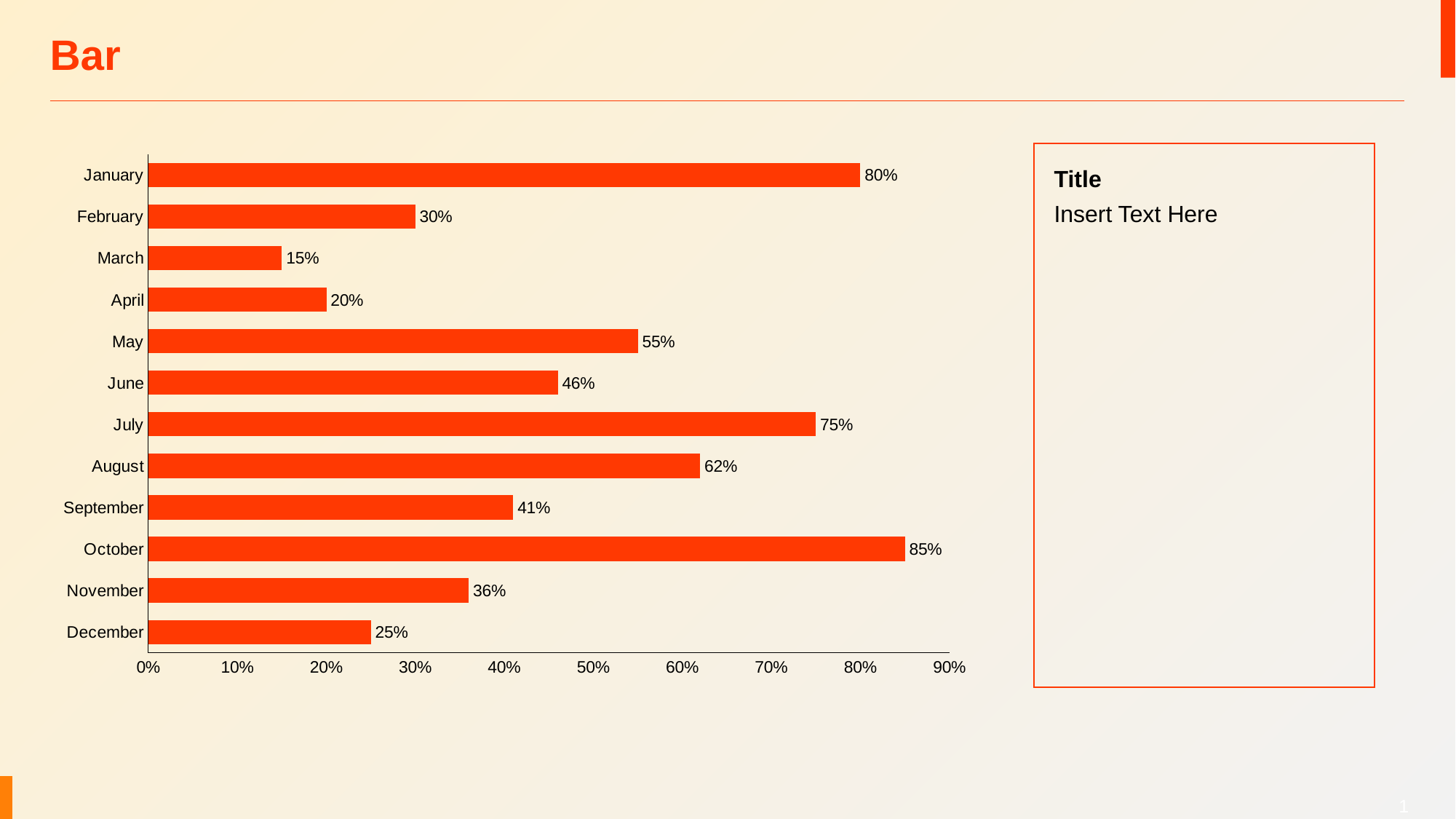
Is the value for June greater or less than 40%? greater What is the value for January? 80% Which month has the lowest value? March What colour are the bars in the chart? Orange-red What is the difference between the values for May and April? 35% What kind of chart is shown on the slide? Bar chart What is the value for September? 41% Which is larger, the value for July or the value for August? July What is the difference between the values for October and January? 5% What is the value for December? 25% How many months are shown on the chart? 12 Which month has the highest value? October